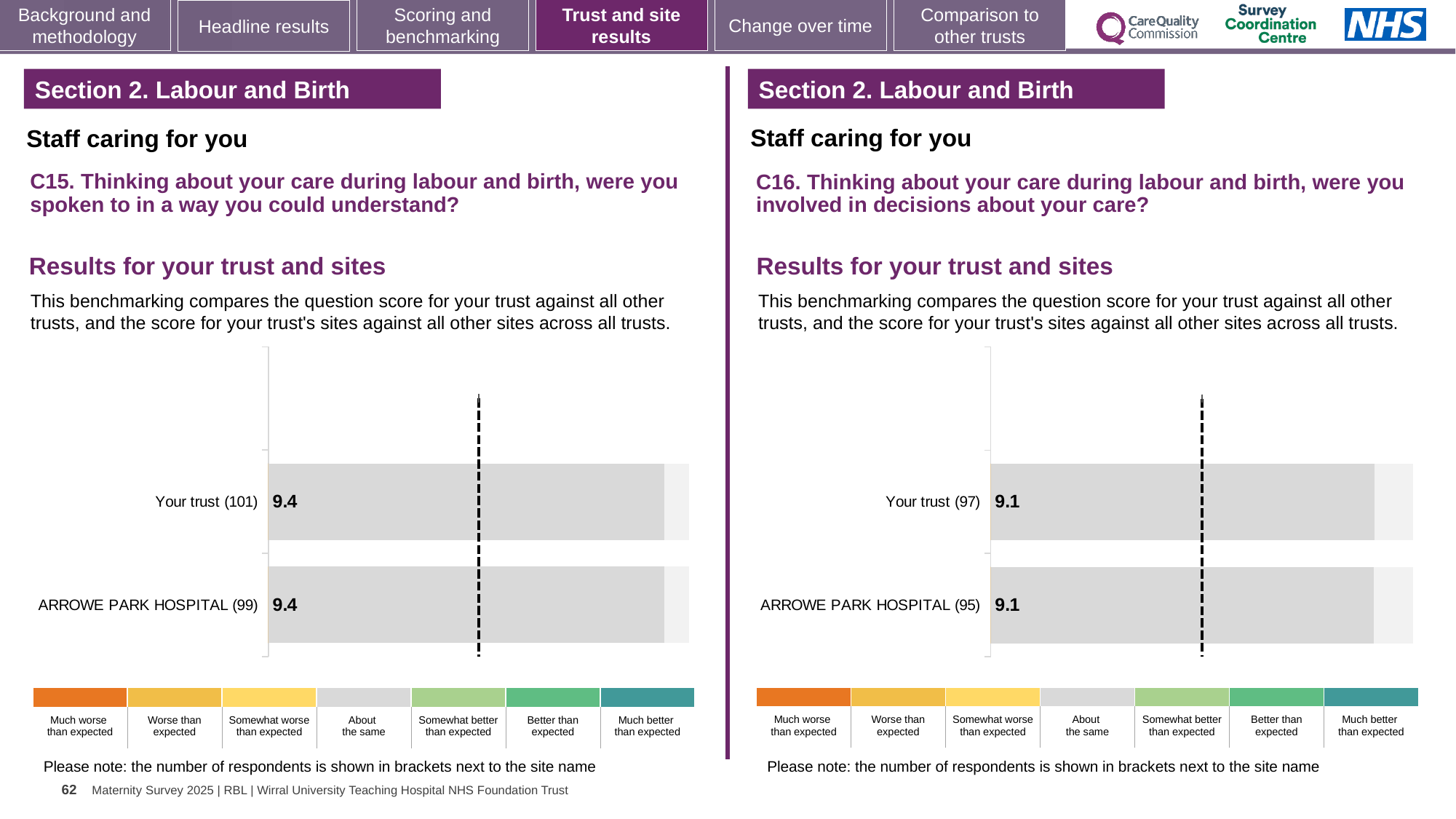
In the C16 chart on the right, what is the score for ARROWE PARK HOSPITAL? 9.1 In the C15 chart on the left, what is the score for ARROWE PARK HOSPITAL? 9.4 What kind of chart is used for the C15 results on the left? Bar chart How many bars are plotted in the C16 chart on the right? 2 In the C15 chart on the left, what is the score for Your trust? 9.4 How many bars are plotted in the C15 chart on the left? 2 In the C16 chart on the right, how many respondents are shown in brackets for ARROWE PARK HOSPITAL? 95 Which is larger: the Your trust score in the C15 chart on the left or the Your trust score in the C16 chart on the right? C15 (9.4) In the C16 chart on the right, what is the score for Your trust? 9.1 What is the difference between the Your trust score in the C15 chart and the Your trust score in the C16 chart? 0.3 How many benchmark categories does the colour key below the C16 chart list? 7 In the C15 chart on the left, how many respondents are shown in brackets for Your trust? 101